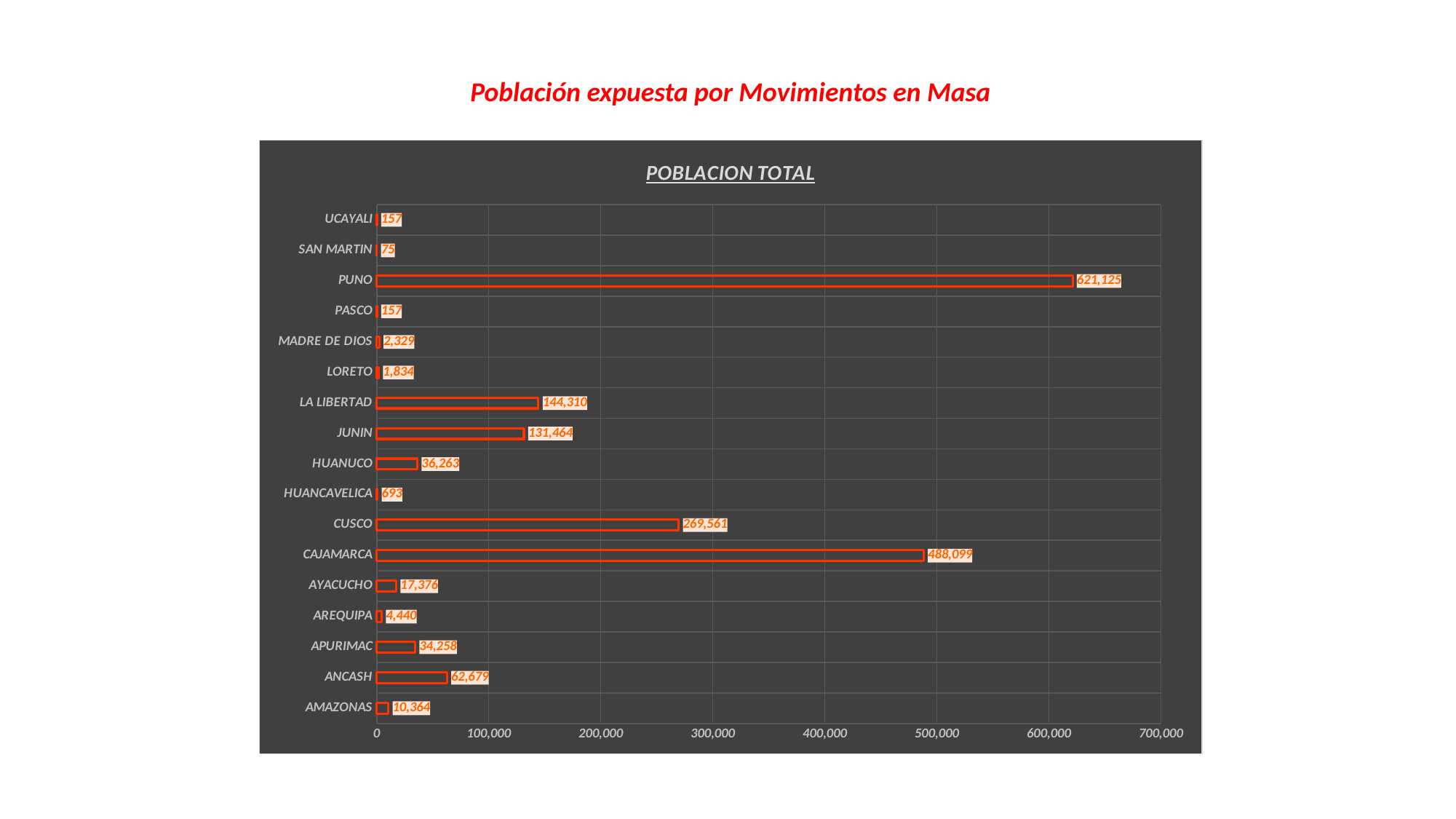
How many categories are shown in the chart? 17 What is the value for AYACUCHO? 17,376 Which category has the highest value? PUNO What is the value for LA LIBERTAD? 144,310 What is the value for PUNO? 621,125 Which category has the lowest value? SAN MARTIN Is the value for CUSCO greater or less than 200,000? greater Which is larger, the value for CUSCO or the value for CAJAMARCA? CAJAMARCA What is the difference between the values for LA LIBERTAD and JUNIN? 12,846 What kind of chart is shown on the slide? bar chart What is the difference between the values for PUNO and CAJAMARCA? 133,026 What is the value for CAJAMARCA? 488,099